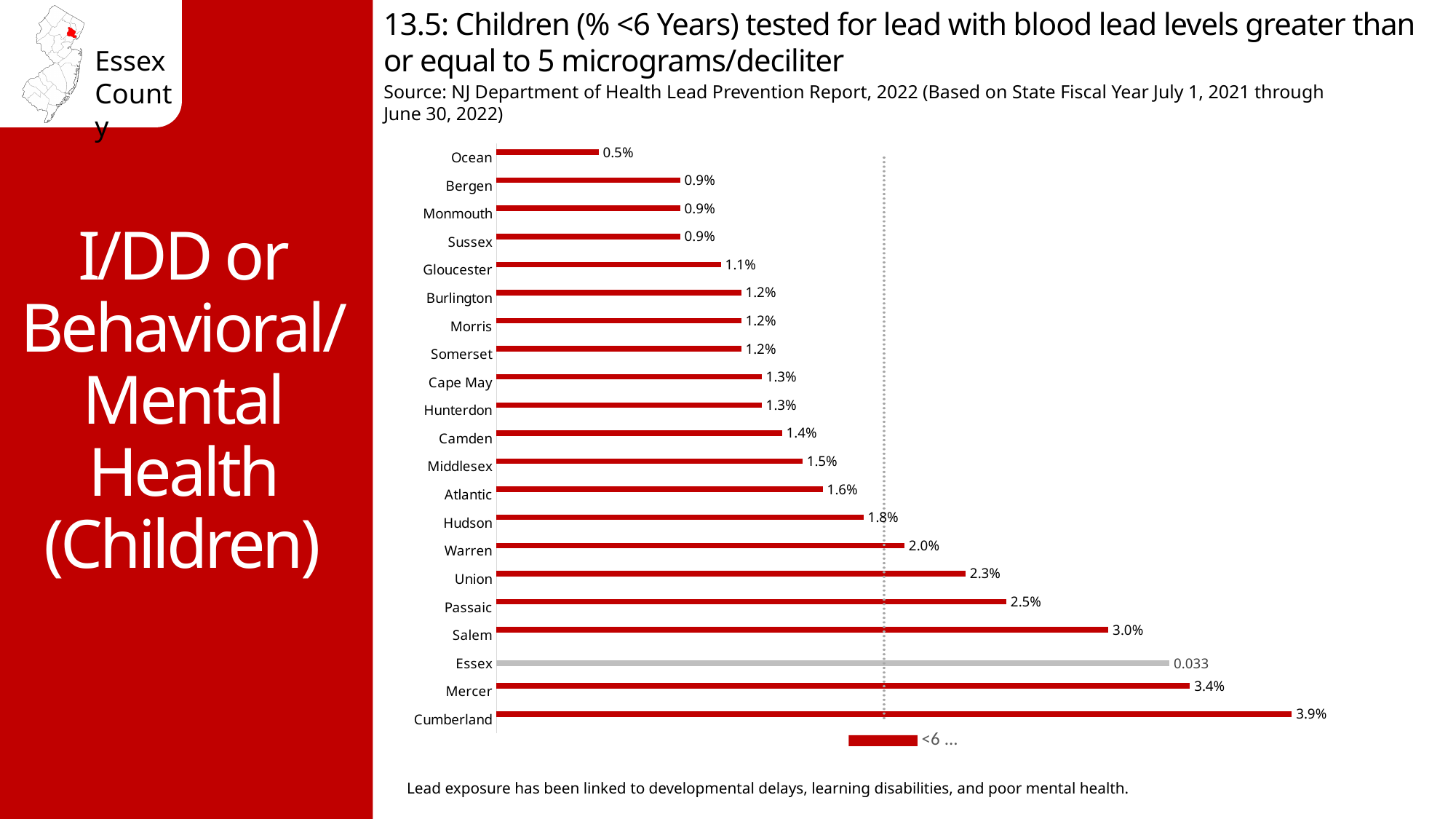
What is the difference between the values for Cumberland and Ocean? 3.4% Which county's bar is drawn in gray instead of red? Essex Which county has the lowest value? Ocean Which has a larger value, Passaic or Union? Passaic Which county has the highest value? Cumberland Which has a larger value, Atlantic or Camden? Atlantic What kind of chart is shown on the slide? Bar chart What is the difference between the values for Mercer and Salem? 0.4% What is the value for Cumberland? 3.9% What is the value for Hudson? 1.8% How many counties are shown in the chart? 21 What value is printed next to the Essex bar? 0.033